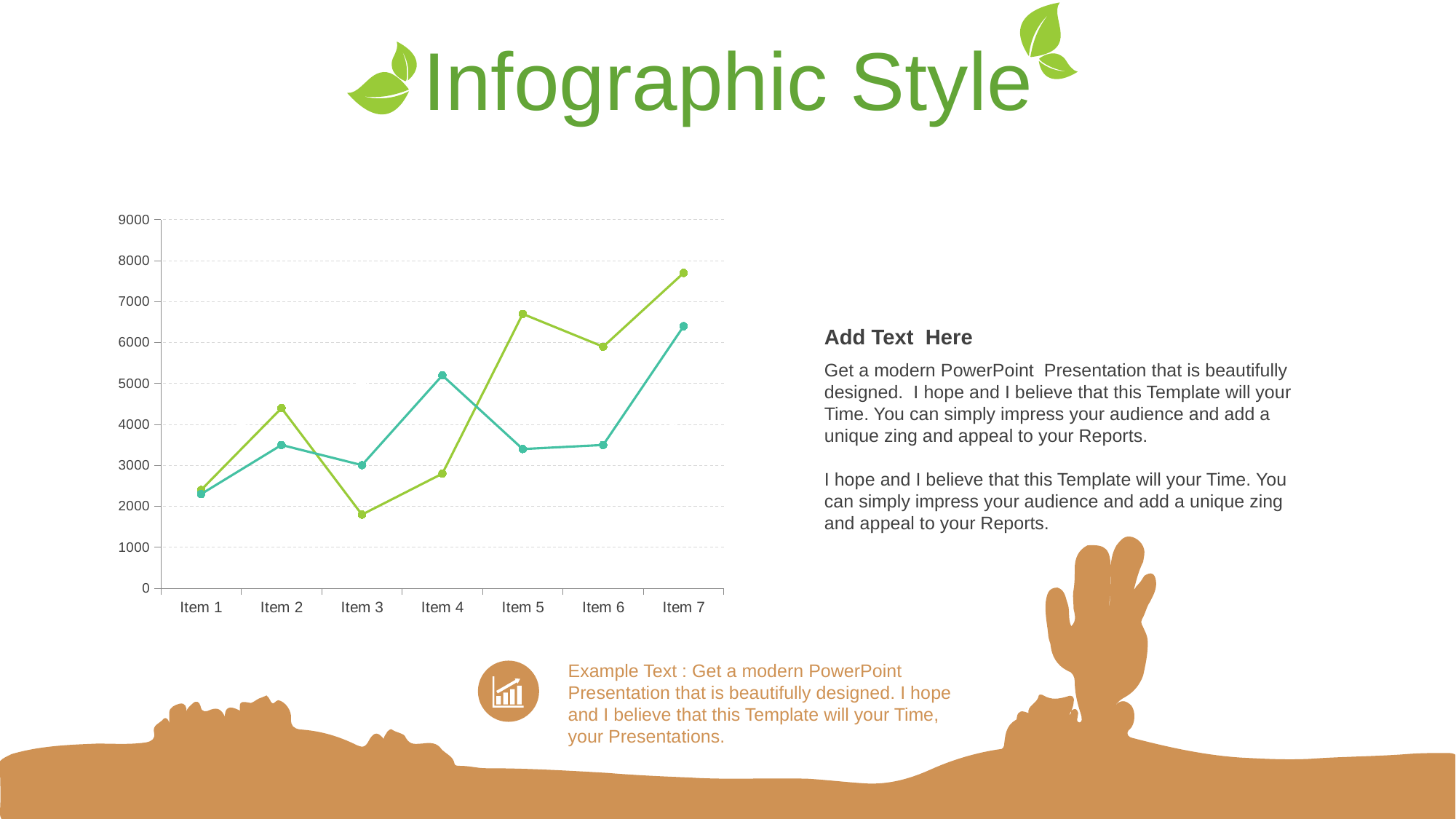
How many categories are shown on the x axis of the chart? 7 What kind of chart is shown on the slide? line chart Is the value of the light green line at Item 5 greater or less than 6000? greater At which item does the teal line reach its highest value? Item 7 At Item 5, which line has the higher value, the light green line or the teal line? the light green line At which item does the light green line reach its lowest value? Item 3 Is the value of the light green line at Item 7 greater or less than 7000? greater Is the value of the teal line at Item 7 greater or less than 6000? greater How many lines are plotted on the chart? 2 At which item does the light green line reach its highest value? Item 7 What is the highest value shown on the chart's vertical axis? 9000